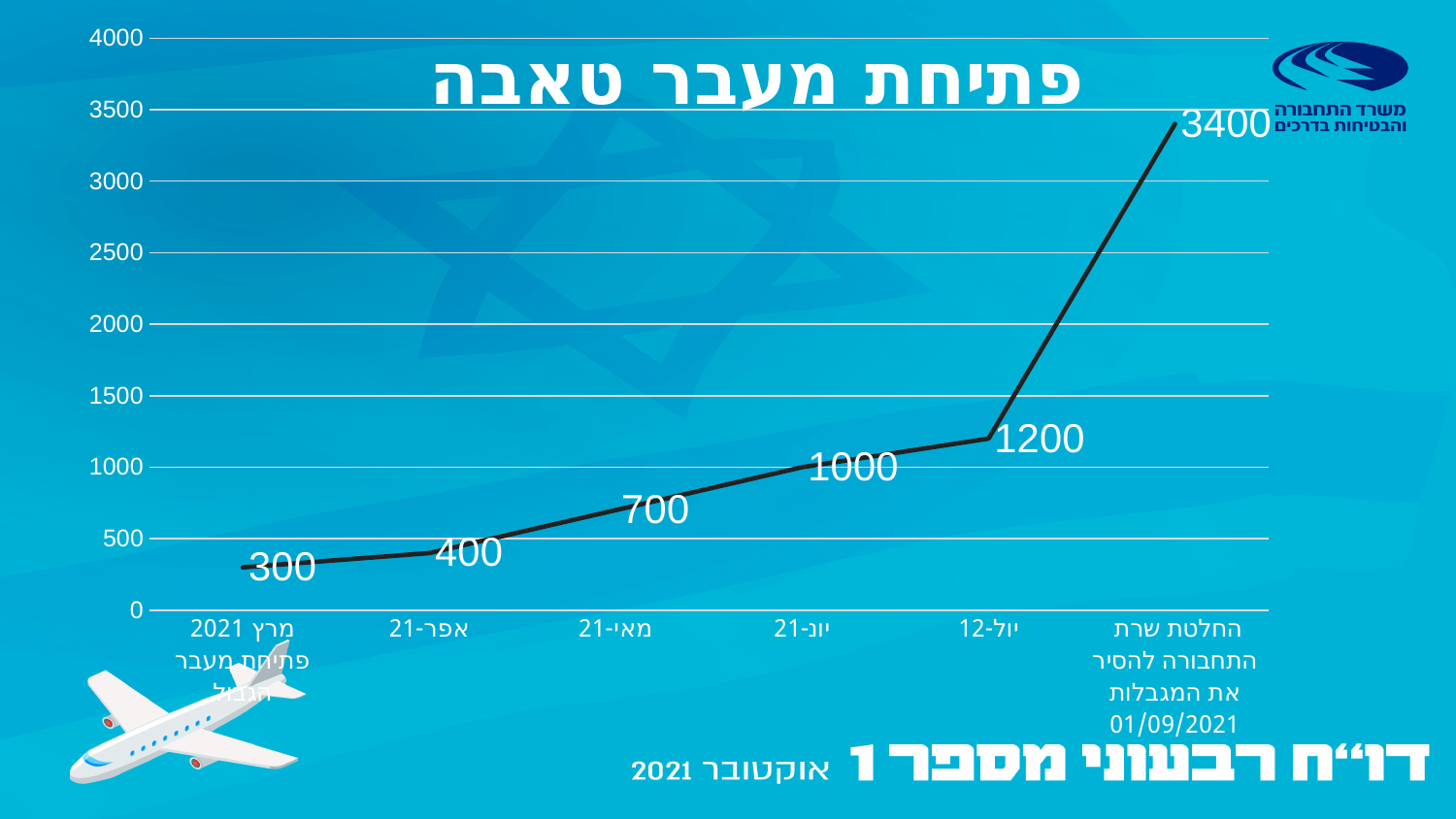
Which point on the chart has the lowest value? מרץ 2021 פתיחת מעבר הגבול How many data points are plotted on the line? 6 What is the difference between the last point (3400) and the point for יול-12? 2200 What type of chart is shown on the slide? line chart Which point on the chart has the highest value? החלטת שרת התחבורה להסיר את המגבלות 01/09/2021 What is the value for the last point, החלטת שרת התחבורה להסיר את המגבלות 01/09/2021? 3400 What is the title of the chart? פתיחת מעבר טאבה What is the value for the first point, מרץ 2021 פתיחת מעבר הגבול? 300 What is the difference between the value for יול-12 and the value for אפר-21? 800 What is the value for יונ-21? 1000 What is the value for מאי-21? 700 Which is larger, the value for מאי-21 or the value for אפר-21? מאי-21